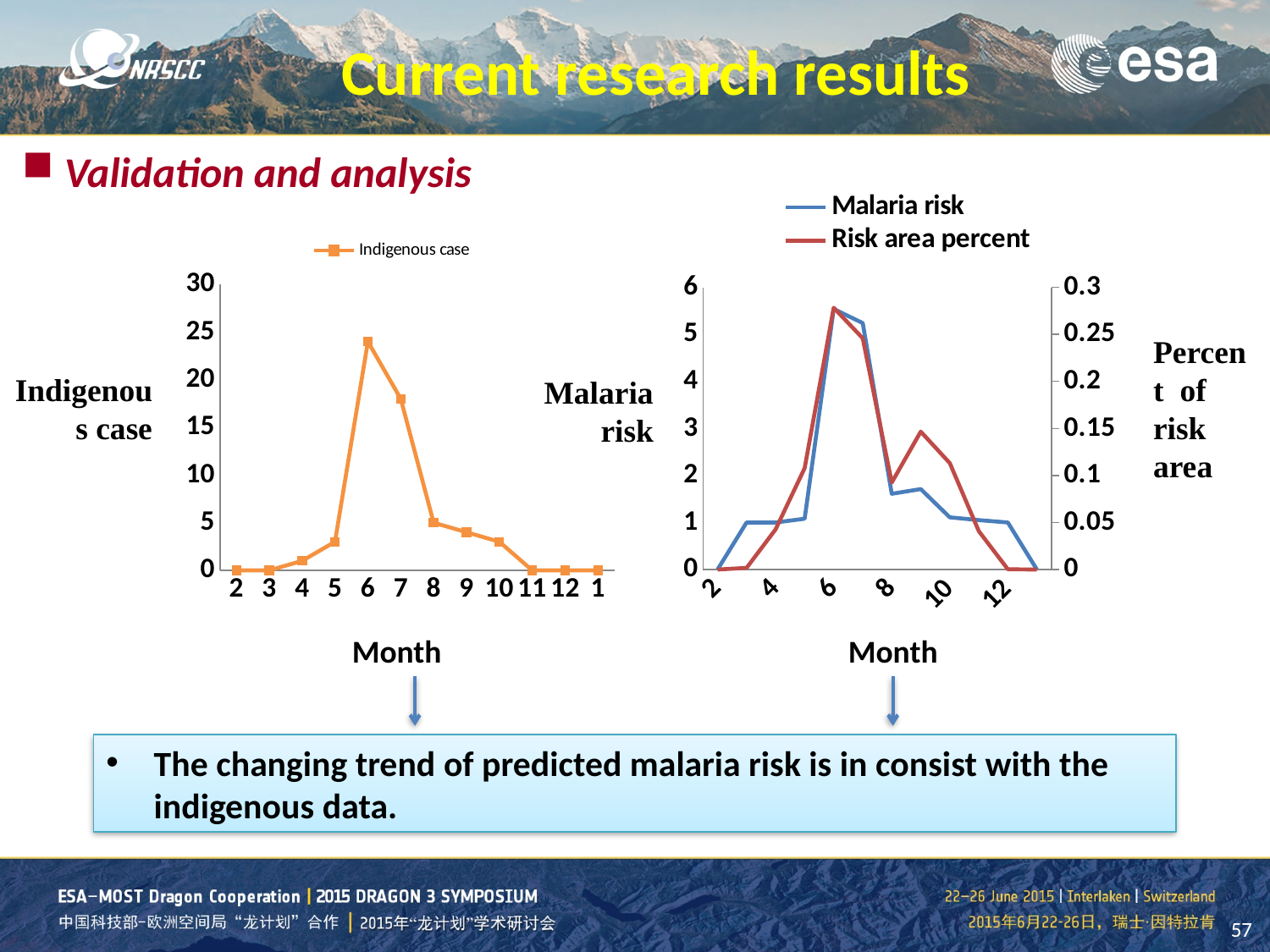
In the left chart (Indigenous case), which is larger, the value for month 6 or the value for month 9? month 6 In the left chart (Indigenous case), which month has the highest number of indigenous cases? 6 In the left chart (Indigenous case), is the value for month 5 greater or less than 5? less In the left chart (Indigenous case), do the values rise or fall from month 6 to month 11? fall In the left chart (Indigenous case), how many months are plotted along the x axis? 12 In the left chart (Indigenous case), is the value for month 7 greater or less than 20? less In the right chart, is the Malaria risk value for month 6 greater or less than 5? greater What kind of chart is the left chart titled 'Indigenous case'? line chart What are the two series named in the legend of the right chart? Malaria risk and Risk area percent How many series does the legend of the right chart list? 2